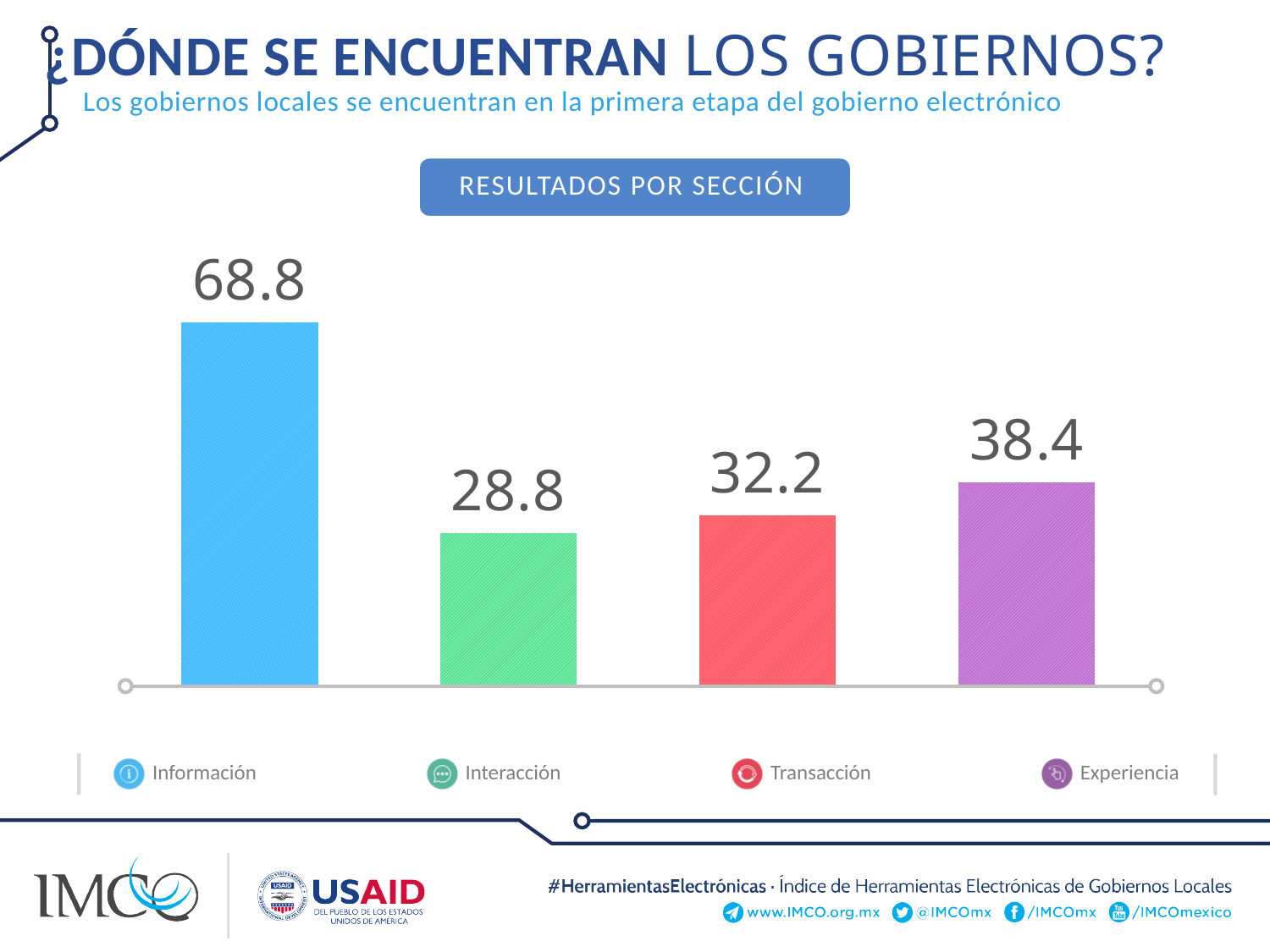
What is the title shown in the box above the chart? RESULTADOS POR SECCIÓN What is the value for Experiencia? 38.4 Which section has the highest value? Información Which section has the lowest value? Interacción What kind of chart is shown on the slide? Bar chart What is the value for Transacción? 32.2 What is the difference between the values for Información and Experiencia? 30.4 How many sections are shown in the chart? 4 What is the difference between the values for Transacción and Interacción? 3.4 Which is larger, the value for Experiencia or the value for Transacción? Experiencia What is the value for Información? 68.8 What is the value for Interacción? 28.8